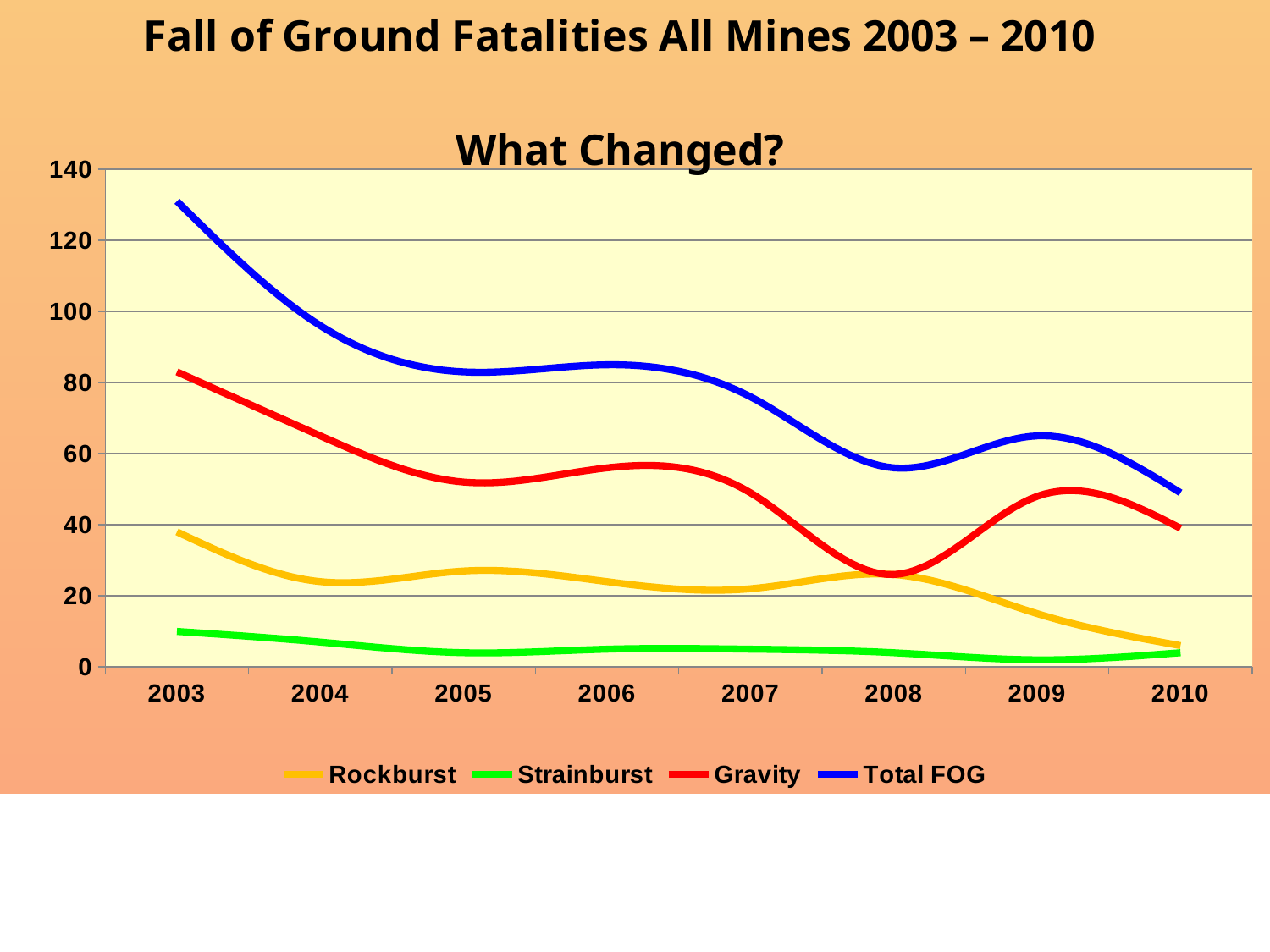
What kind of chart is shown on the slide? line chart What colour is the Gravity line in the legend? red Is the value for Total FOG in 2003 greater or less than 120? greater In which year is Total FOG highest? 2003 Does Total FOG generally rise or fall from 2003 to 2010? fall In which year is Total FOG lowest? 2010 How many years are shown along the x axis? 8 Which series has the highest value in 2003? Total FOG Is the value for Gravity in 2008 greater or less than 40? less Is the value for Total FOG in 2010 greater or less than 60? less How many series does the legend list? 4 In 2003, which is larger: Rockburst or Strainburst? Rockburst